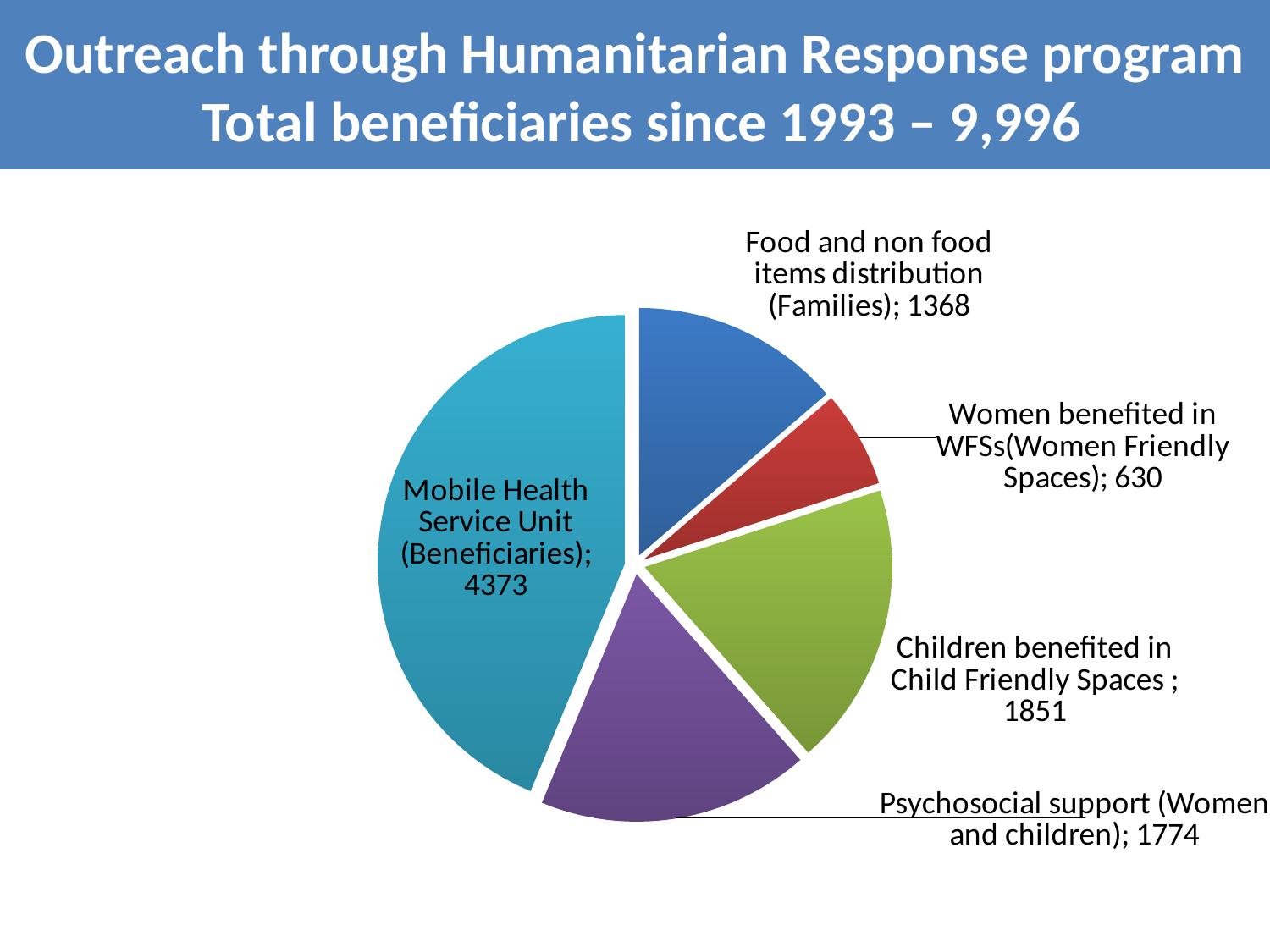
What is the difference between the Mobile Health Service Unit value and the Children benefited in Child Friendly Spaces value? 2522 Which is larger: Children benefited in Child Friendly Spaces or Psychosocial support (Women and children)? Children benefited in Child Friendly Spaces What share of the pie does Mobile Health Service Unit (Beneficiaries) represent, to the nearest whole percent? 44% How many slices does the pie chart have? 5 Which category has the smallest slice of the pie? Women benefited in WFSs (Women Friendly Spaces) What kind of chart is shown on the slide? Pie chart Which category has the largest slice of the pie? Mobile Health Service Unit (Beneficiaries) What is the title of the slide containing the chart? Outreach through Humanitarian Response program Total beneficiaries since 1993 – 9,996 What is the value for Psychosocial support (Women and children)? 1774 What is the value for Women benefited in WFSs (Women Friendly Spaces)? 630 What is the total of all the slices in the pie chart? 9996 What is the value for Mobile Health Service Unit (Beneficiaries)? 4373